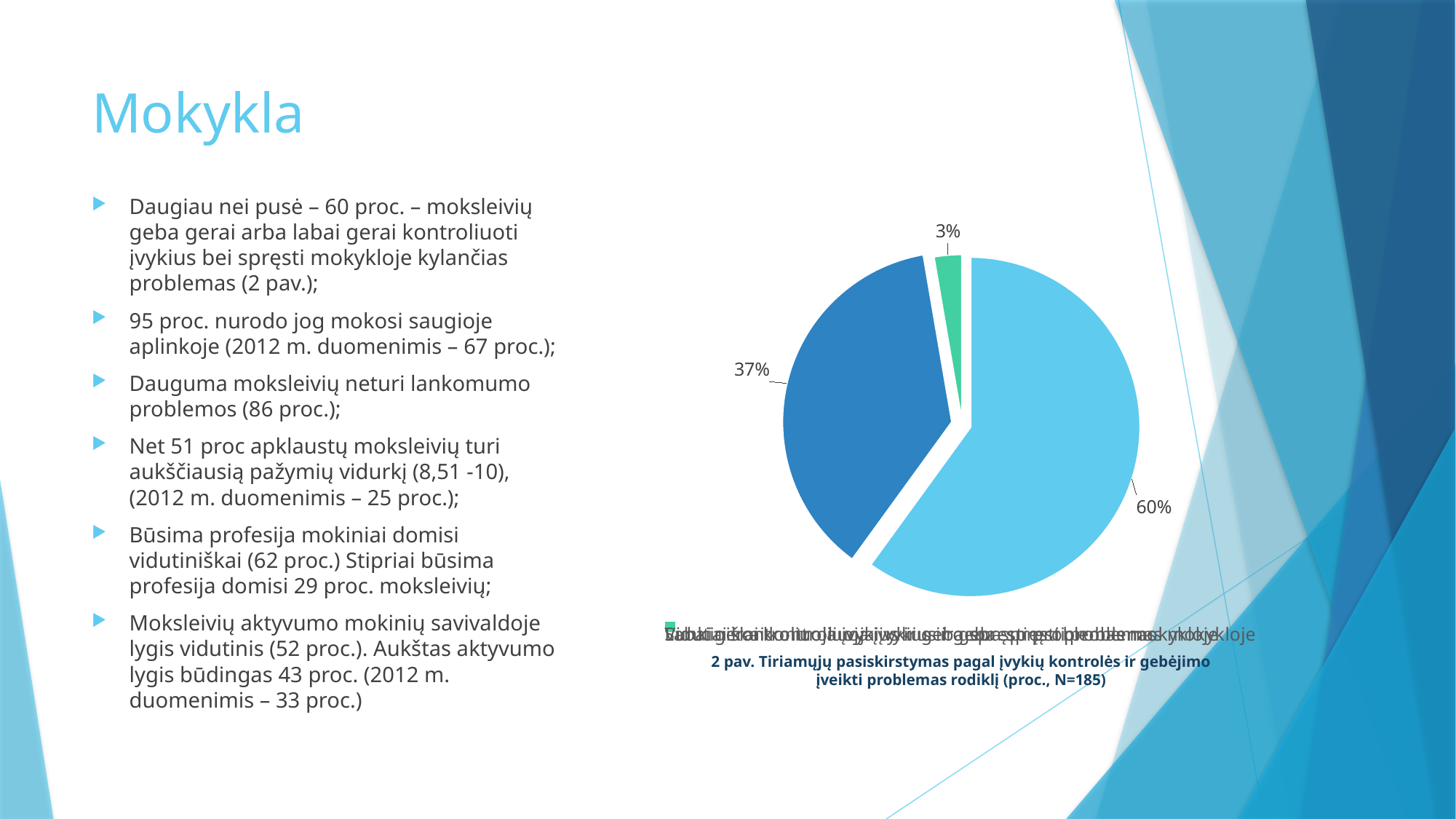
How many slices does the pie chart have? 3 What sample size (N) is stated in the caption of the pie chart? N=185 What is the value of the smallest slice of the pie chart? 3% What is the value of the dark blue slice of the pie chart? 37% What is the difference between the 60% slice and the 37% slice of the pie chart? 23% What is the difference between the largest and the smallest slice of the pie chart? 57% What kind of chart is shown on the slide? pie chart What is the value of the green slice of the pie chart? 3% What is the value of the largest slice of the pie chart? 60% Which slice is larger in the pie chart, the dark blue one or the green one? the dark blue one What figure number is given in the caption of the pie chart? 2 pav. What is the value of the light blue slice of the pie chart? 60%